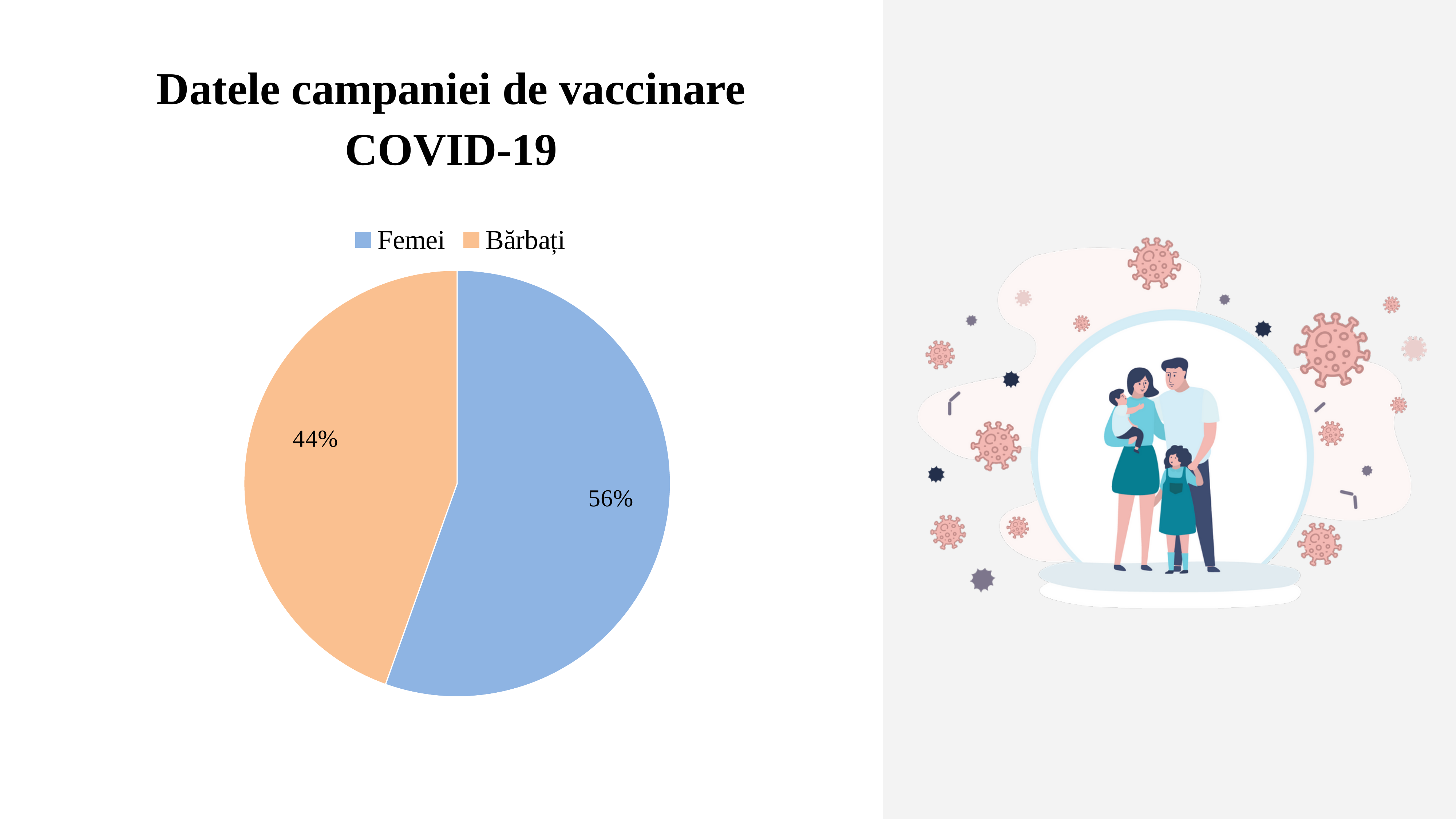
What kind of chart is shown on the slide? Pie chart Which slice is larger, Femei or Bărbați? Femei How many entries does the legend list? 2 What colour is the Bărbați slice? Orange How many slices does the pie chart have? 2 Which category has the smallest slice of the pie? Bărbați What share of the pie does Femei represent? 56% What share of the pie does Bărbați represent? 44% What is the title shown above the chart? Datele campaniei de vaccinare COVID-19 What is the difference in percentage points between the Femei and Bărbați slices? 12 Which category has the largest slice of the pie? Femei